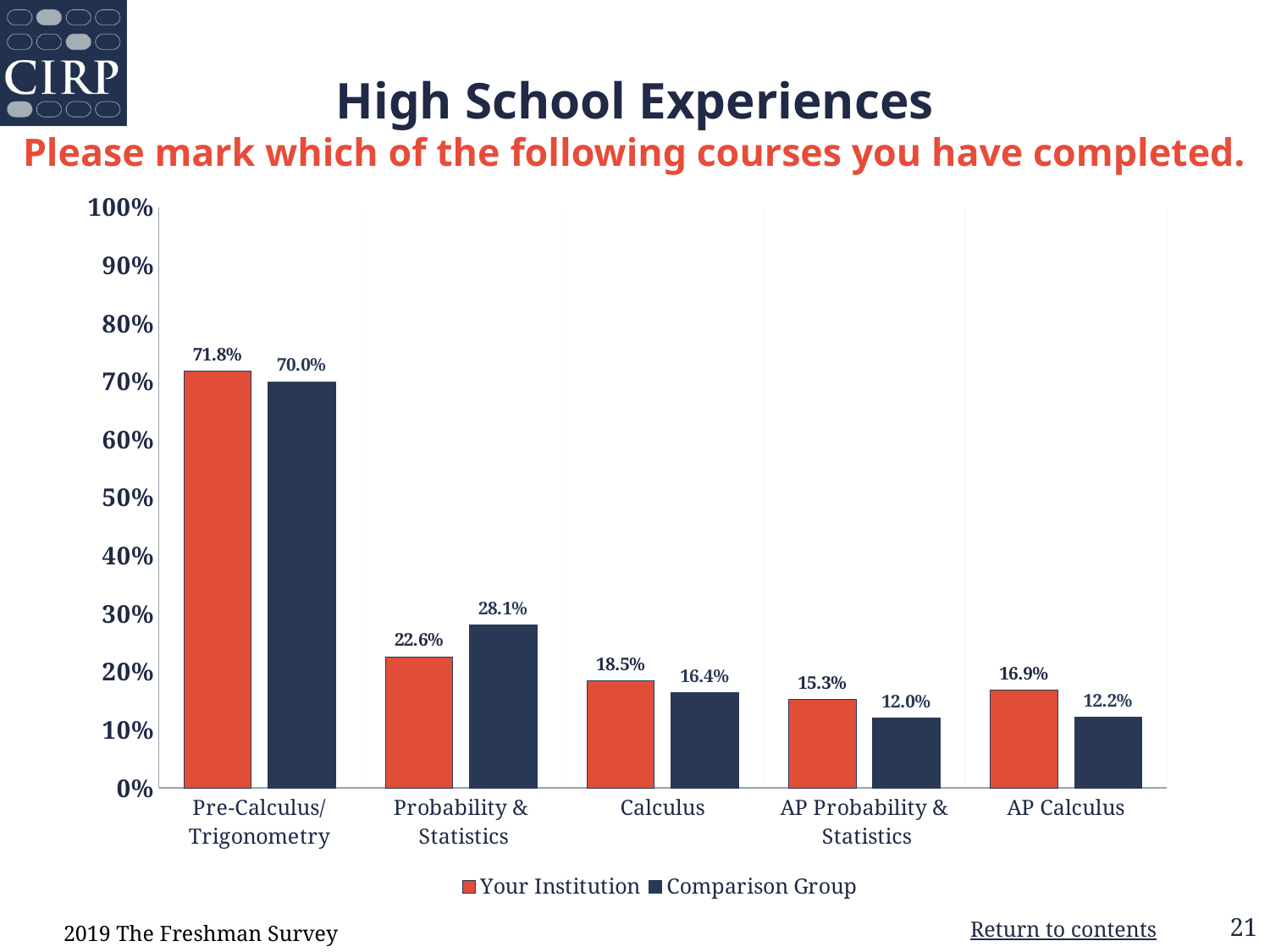
What kind of chart is shown on the slide? bar chart For Probability & Statistics, which is larger: Your Institution or Comparison Group? Comparison Group What percentage of Your Institution students completed Pre-Calculus/Trigonometry? 71.8% How many courses are shown on the x axis? 5 What colour represents Your Institution in the chart? Orange-red Is the Comparison Group value for AP Probability & Statistics greater or less than 20%? less Which course has the highest Comparison Group value? Pre-Calculus/Trigonometry What is the Comparison Group value for Probability & Statistics? 28.1% How many series does the legend list? 2 What is the difference between Your Institution and Comparison Group for Calculus? 2.1% What is the Your Institution value for AP Calculus? 16.9% Which course has the lowest Your Institution value? AP Probability & Statistics